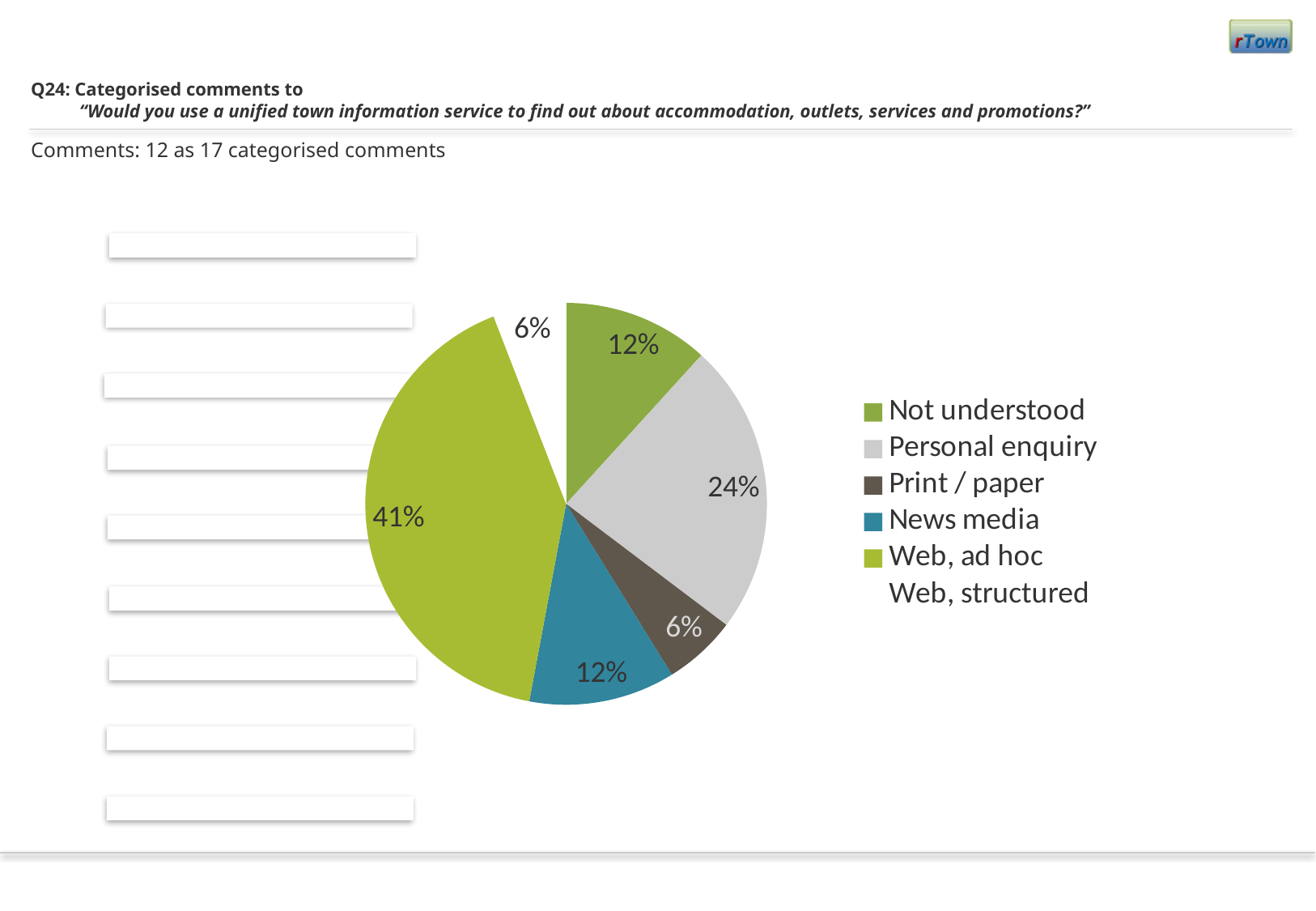
Which is larger, the slice for Personal enquiry or the slice for News media? Personal enquiry What colour is the slice for News media? Teal blue What share of the pie does Print / paper represent? 6% What is the difference in percentage points between the Web, ad hoc slice and the Personal enquiry slice? 17 How many categories does the legend list? 6 What share of the pie does Web, structured represent? 6% What share of the pie does Not understood represent? 12% What kind of chart is shown on the slide? Pie chart Which category has the largest slice of the pie? Web, ad hoc